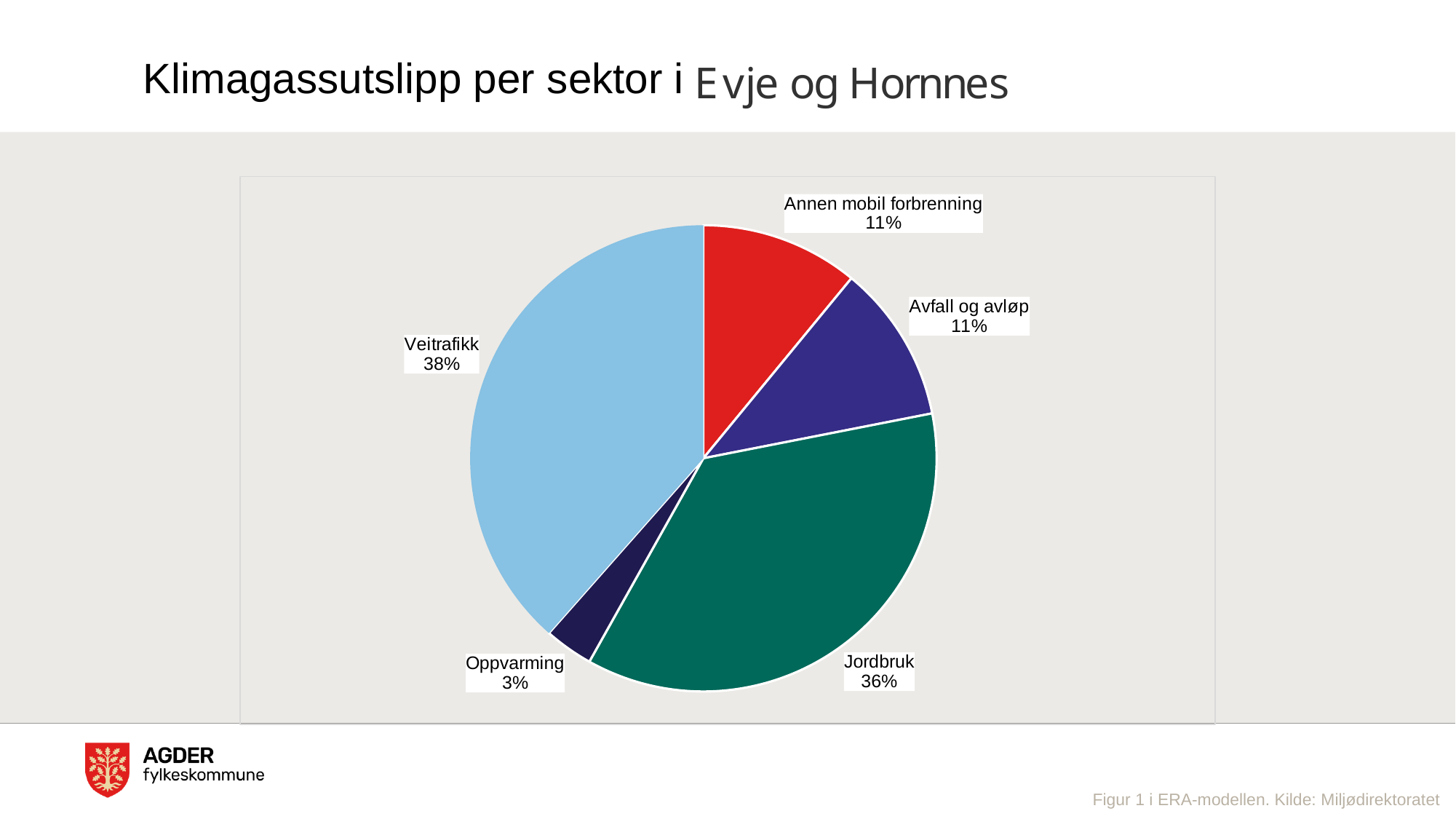
Which sector has the largest share of emissions? Veitrafikk What share of emissions does Jordbruk account for? 36% What is the title of the slide containing the chart? Klimagassutslipp per sektor i Evje og Hornnes What is the value shown for Avfall og avløp? 11% How many sectors are shown in the pie chart? 5 Which is larger, the share for Jordbruk or the share for Annen mobil forbrenning? Jordbruk What is the difference in percentage points between Jordbruk and Oppvarming? 33 What is the value shown for Annen mobil forbrenning? 11% What kind of chart is shown on the slide? pie chart What is the value shown for Oppvarming? 3% Which sector has the smallest share of emissions? Oppvarming What share of emissions does Veitrafikk account for? 38%